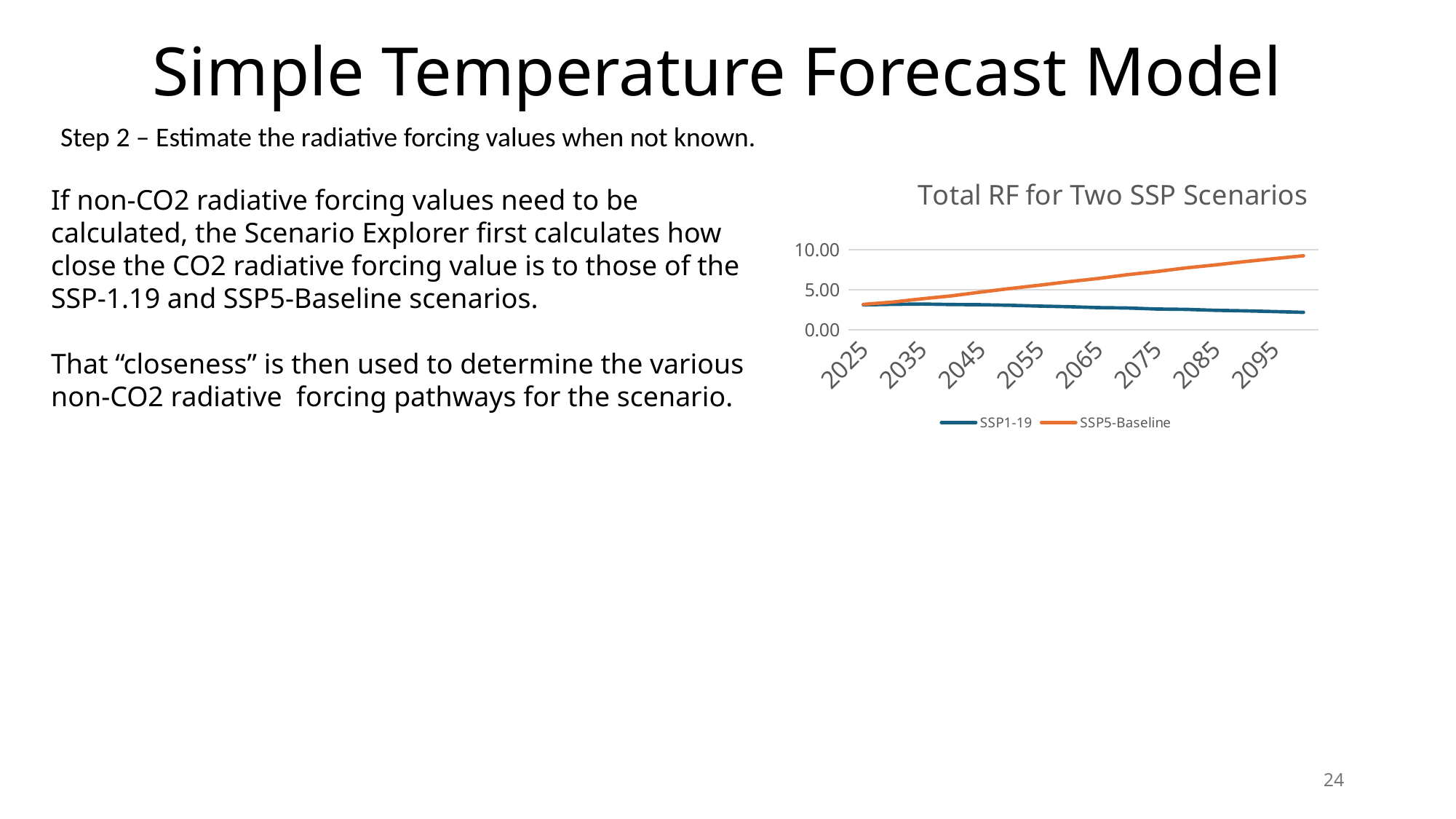
What is the title of the chart? Total RF for Two SSP Scenarios Does the SSP1-19 line rise or fall from 2025 to 2095? fall Is the value for SSP5-Baseline in 2025 greater or less than 5.00? less How many year labels are shown on the x axis of the chart? 8 What kind of chart is shown on the slide? line chart What is the highest value labelled on the y axis of the chart? 10.00 Which series is drawn in orange in the chart? SSP5-Baseline Does the SSP5-Baseline line rise or fall from 2025 to 2095? rise Is the value for SSP1-19 in 2095 greater or less than 5.00? less In 2095, which series has the larger value, SSP1-19 or SSP5-Baseline? SSP5-Baseline How many series does the chart's legend list? 2 Is the value for SSP5-Baseline in 2095 greater or less than 5.00? greater